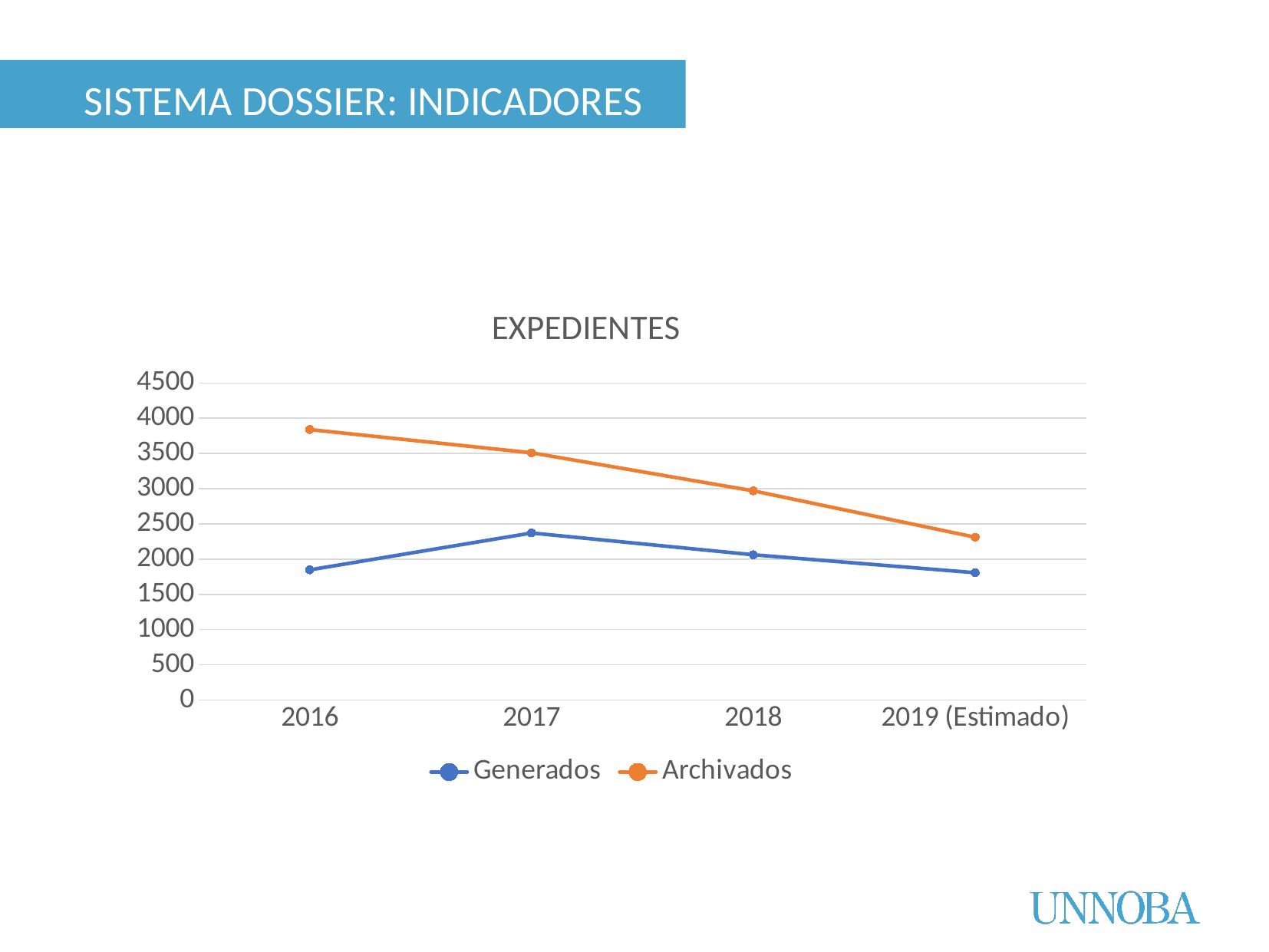
How many points are plotted along the x axis for each series? 4 How many series does the legend list? 2 In which year is the Archivados series at its highest? 2016 Is the value for Archivados in 2016 greater or less than 3500? greater Is the value for Archivados in 2019 (Estimado) greater or less than 2500? less Does the Archivados series rise or fall from 2016 to 2019 (Estimado)? fall What kind of chart is shown on the slide? line chart What is the title of the chart? EXPEDIENTES In which year is the Generados series at its highest? 2017 Which series has the larger value in 2016, Generados or Archivados? Archivados In which year is the Archivados series at its lowest? 2019 (Estimado) Is the value for Generados in 2017 greater or less than 2000? greater